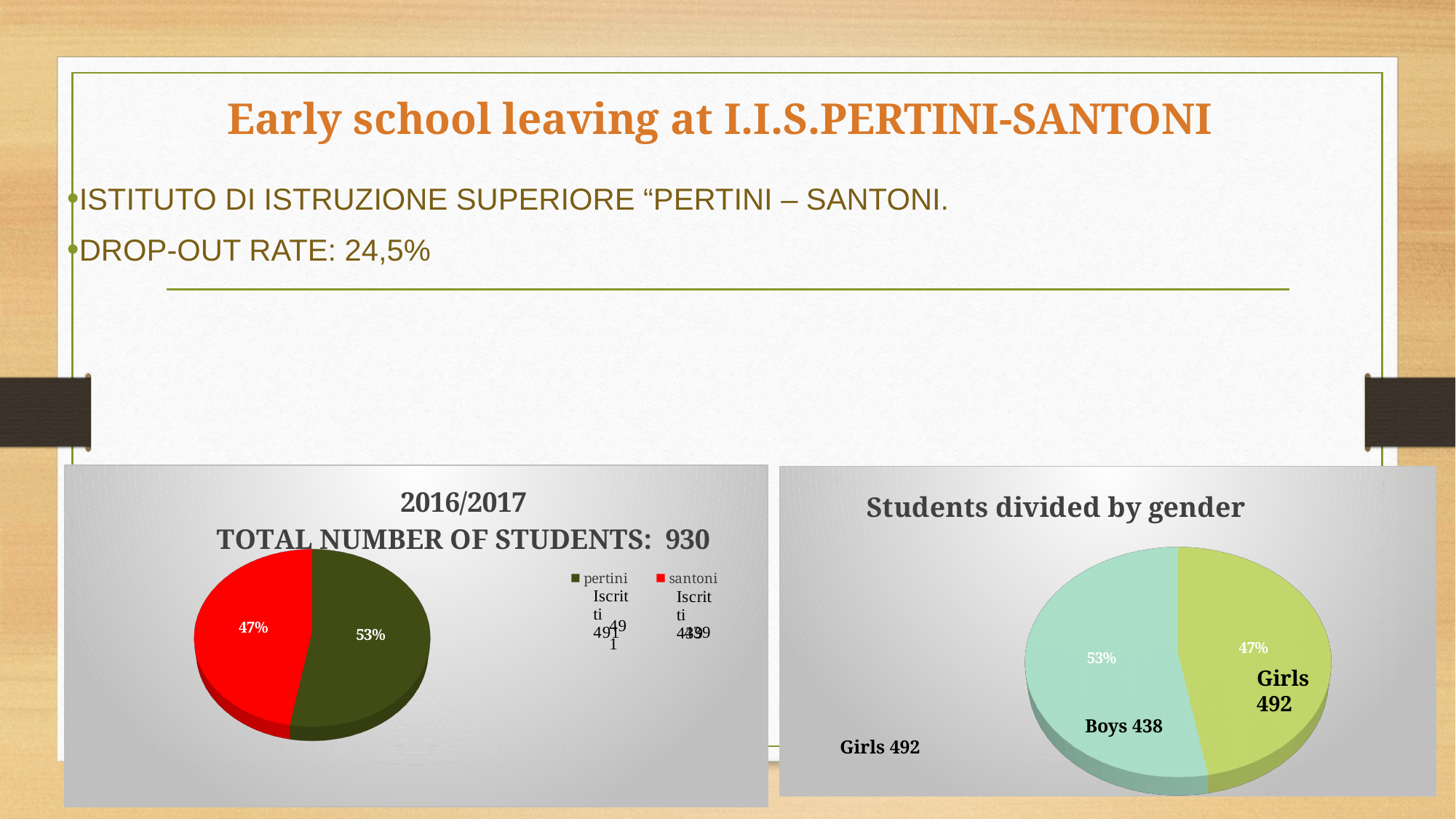
In the chart titled "Students divided by gender", how many slices does the pie have? 2 What type of chart is the chart titled "Students divided by gender"? pie chart What type of chart is the chart titled "2016/2017 TOTAL NUMBER OF STUDENTS: 930"? pie chart In the chart titled "Students divided by gender", how many students are labelled as Girls? 492 In the chart titled "2016/2017 TOTAL NUMBER OF STUDENTS: 930", what colour is the santoni slice? red In the chart titled "2016/2017 TOTAL NUMBER OF STUDENTS: 930", which slice is larger, pertini or santoni? pertini In the chart titled "Students divided by gender", what percentage label is printed on the Boys slice? 53% In the chart titled "Students divided by gender", how many students are labelled as Boys? 438 In the chart titled "2016/2017 TOTAL NUMBER OF STUDENTS: 930", how many entries does the legend list? 2 In the chart titled "Students divided by gender", what is the difference between the Girls count and the Boys count? 54 In the chart titled "2016/2017 TOTAL NUMBER OF STUDENTS: 930", what percentage is shown for santoni? 47% In the chart titled "2016/2017 TOTAL NUMBER OF STUDENTS: 930", what percentage is shown for pertini? 53%